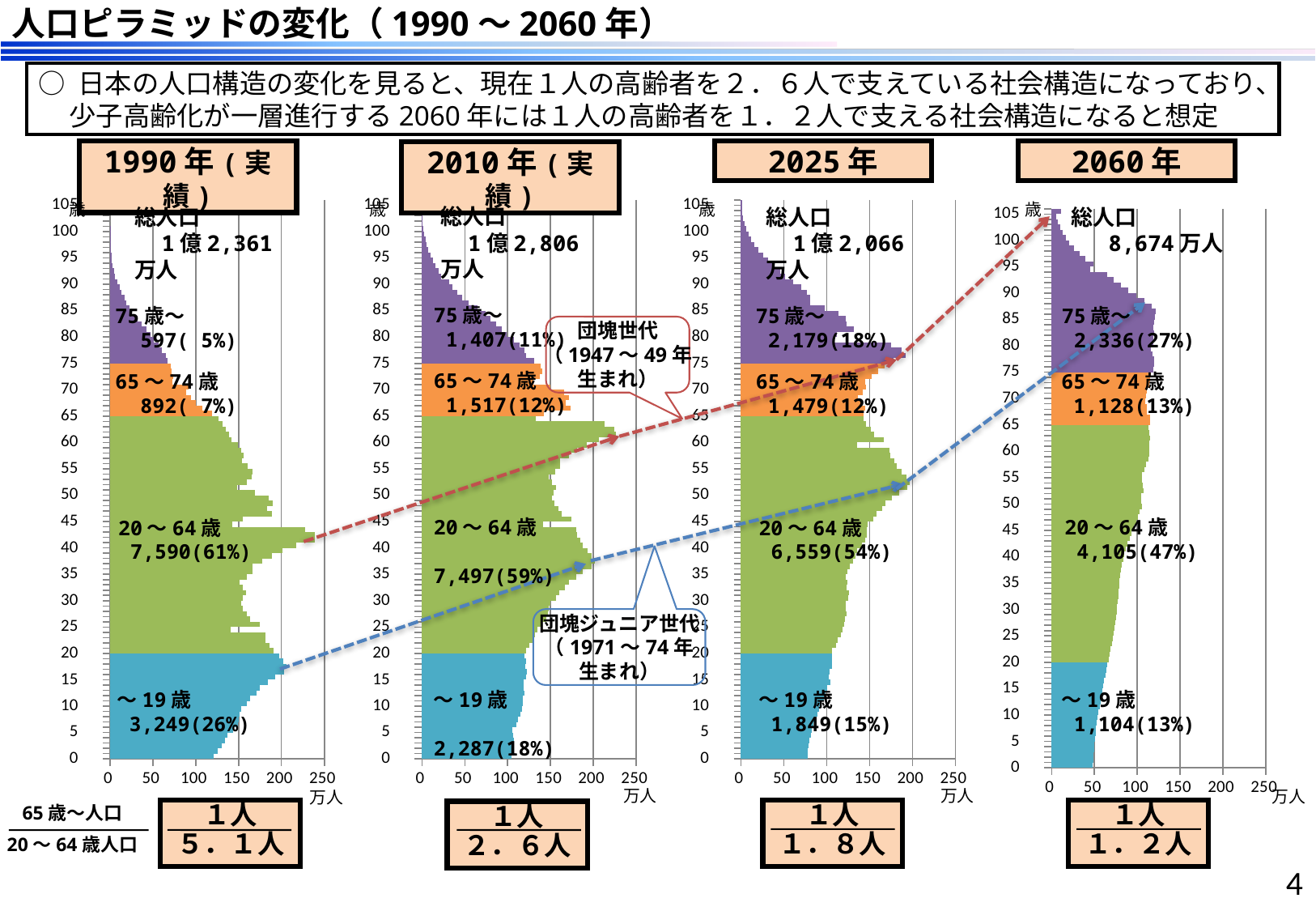
In the 1990年(実績) chart, what is the printed value for the 20～64歳 age group? 7,590(61%) In the 1990年(実績) chart, which age group has the smallest population? 75歳～ What is the difference between the 20～64歳 population in the 2010年(実績) chart (7,497) and in the 2060年 chart (4,105)? 3,392 In the 2025年 chart, what is the total population (総人口) shown? 1億2,066万人 What kind of chart is used for each population pyramid on the slide? Bar chart Across the four charts from 1990 to 2060, does the ～19歳 population rise or fall? Fall What unit is shown on the horizontal axis of the population pyramid charts? 万人 In the 2025年 chart, which is larger: the 75歳～ group or the 65～74歳 group? 75歳～ In the 2060年 chart, what is the printed value for the 75歳～ age group? 2,336(27%) In the 2010年(実績) chart, which age group has the largest population? 20～64歳 In the 2010年(実績) chart, what percentage is shown for the 65～74歳 age group? 12% How many age groups are labelled in each population pyramid chart? 4